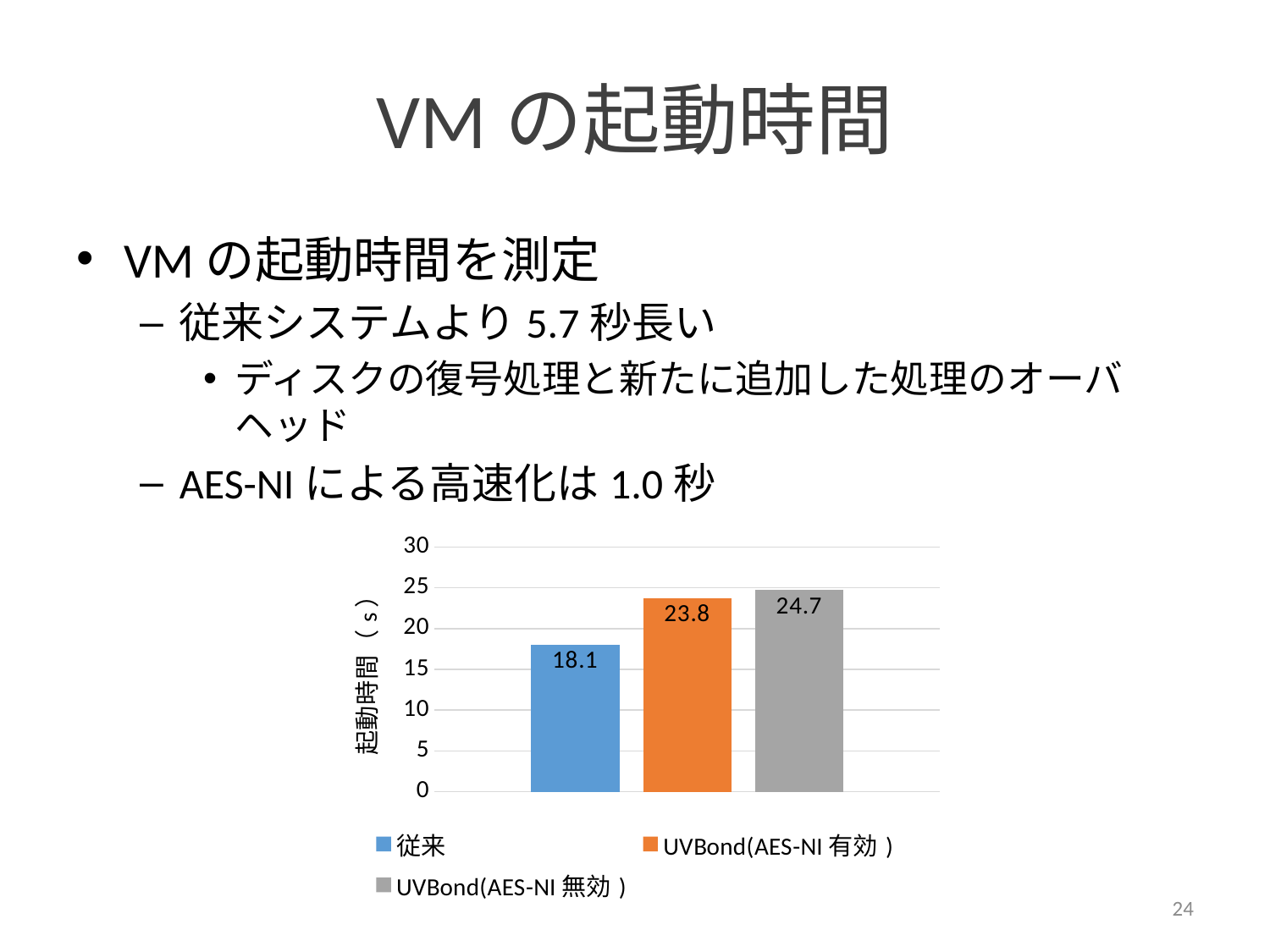
What is the difference between the values for UVBond(AES-NI 無効) and UVBond(AES-NI 有効)? 0.9 Which series has the lowest value in the chart? 従来 What is the value for UVBond(AES-NI 有効) in the chart? 23.8 What is the value for 従来 in the chart? 18.1 What is the value for UVBond(AES-NI 無効) in the chart? 24.7 What is the difference between the values for UVBond(AES-NI 有効) and 従来? 5.7 How many series does the legend list? 3 Which series has the highest value in the chart? UVBond(AES-NI 無効) Is the value for 従来 greater or less than 20? less What kind of chart is shown on the slide? bar chart Which is larger, the value for 従来 or the value for UVBond(AES-NI 有効)? UVBond(AES-NI 有効) What is the label of the vertical axis of the chart? 起動時間 (s)